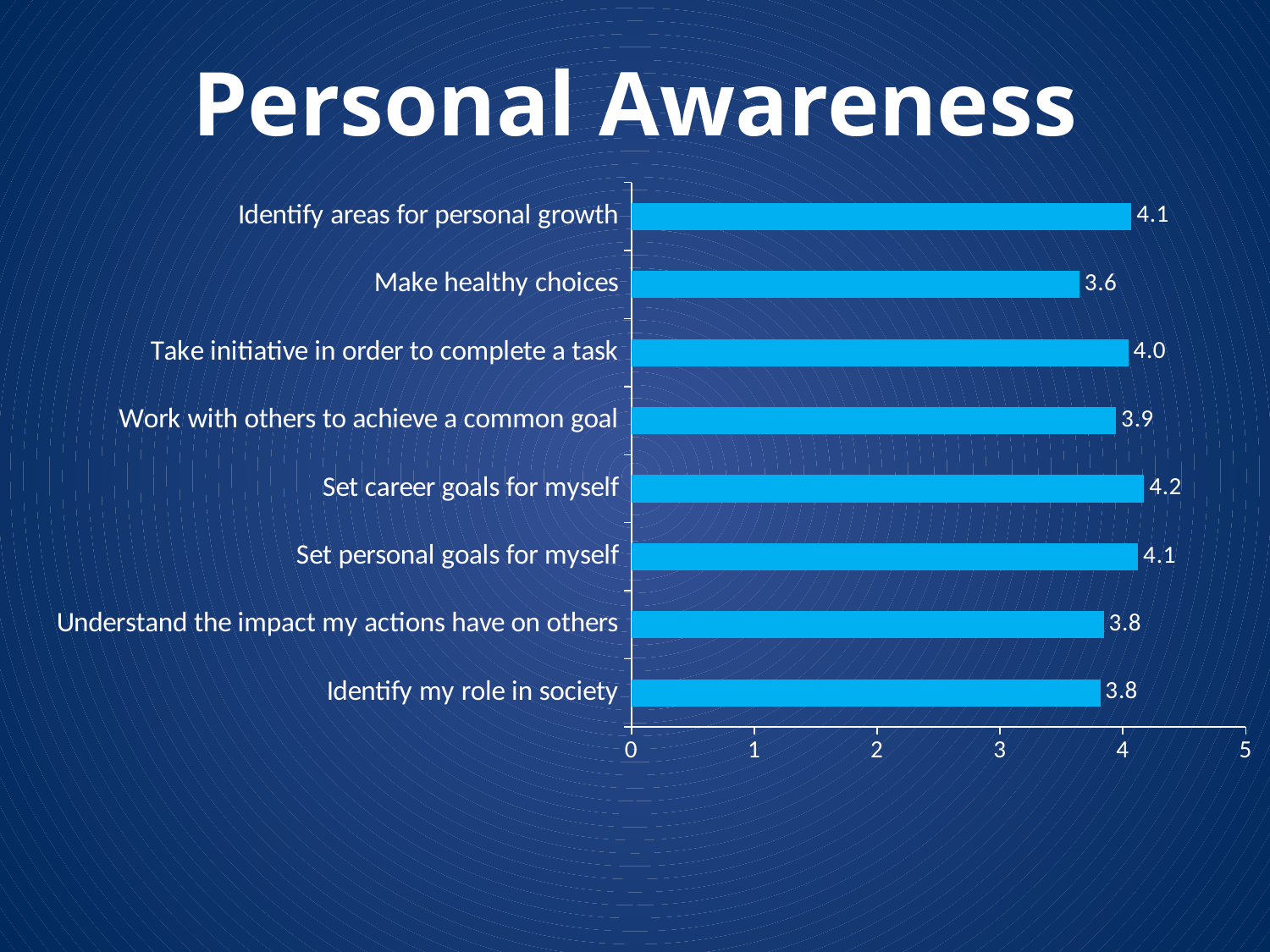
Which category has the highest value? Set career goals for myself Which category has the lowest value? Make healthy choices Is the value for "Identify my role in society" greater or less than 4? less What is the value for "Work with others to achieve a common goal"? 3.9 What is the title of the slide? Personal Awareness What is the difference between the values for "Set career goals for myself" and "Make healthy choices"? 0.6 How many categories are shown in the chart? 8 What is the value for "Set career goals for myself"? 4.2 What is the value for "Take initiative in order to complete a task"? 4.0 What kind of chart is shown on the slide? Bar chart Which is larger, the value for "Identify areas for personal growth" or the value for "Understand the impact my actions have on others"? Identify areas for personal growth What is the value for "Make healthy choices"? 3.6